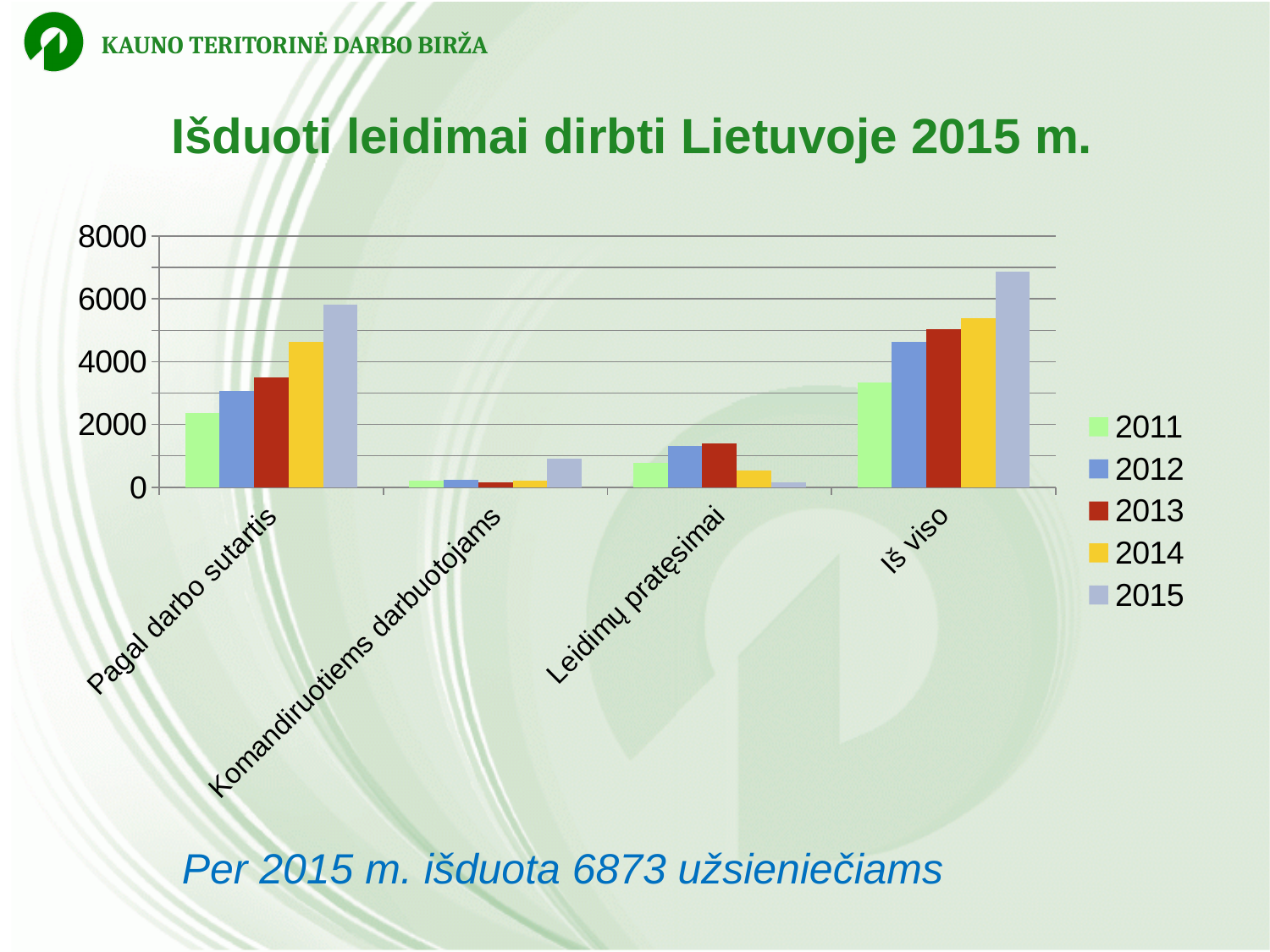
Is the 2013 value for 'Leidimų pratęsimai' greater or less than 2000? less What is the title of the chart? Išduoti leidimai dirbti Lietuvoje 2015 m. Which year has the lowest bar in the 'Pagal darbo sutartis' category? 2011 How many categories are shown on the x axis? 4 Which year has the highest bar in the 'Iš viso' category? 2015 What type of chart is shown on the slide? bar chart Do the values for 'Pagal darbo sutartis' rise or fall from 2011 to 2015? rise Is the 2015 value for 'Pagal darbo sutartis' greater or less than 4000? greater Is the 2015 value for 'Iš viso' greater or less than 6000? greater How many series does the legend list? 5 Which is larger for 'Leidimų pratęsimai': the 2014 value or the 2015 value? 2014 Which category has the lowest bars overall? Komandiruotiems darbuotojams